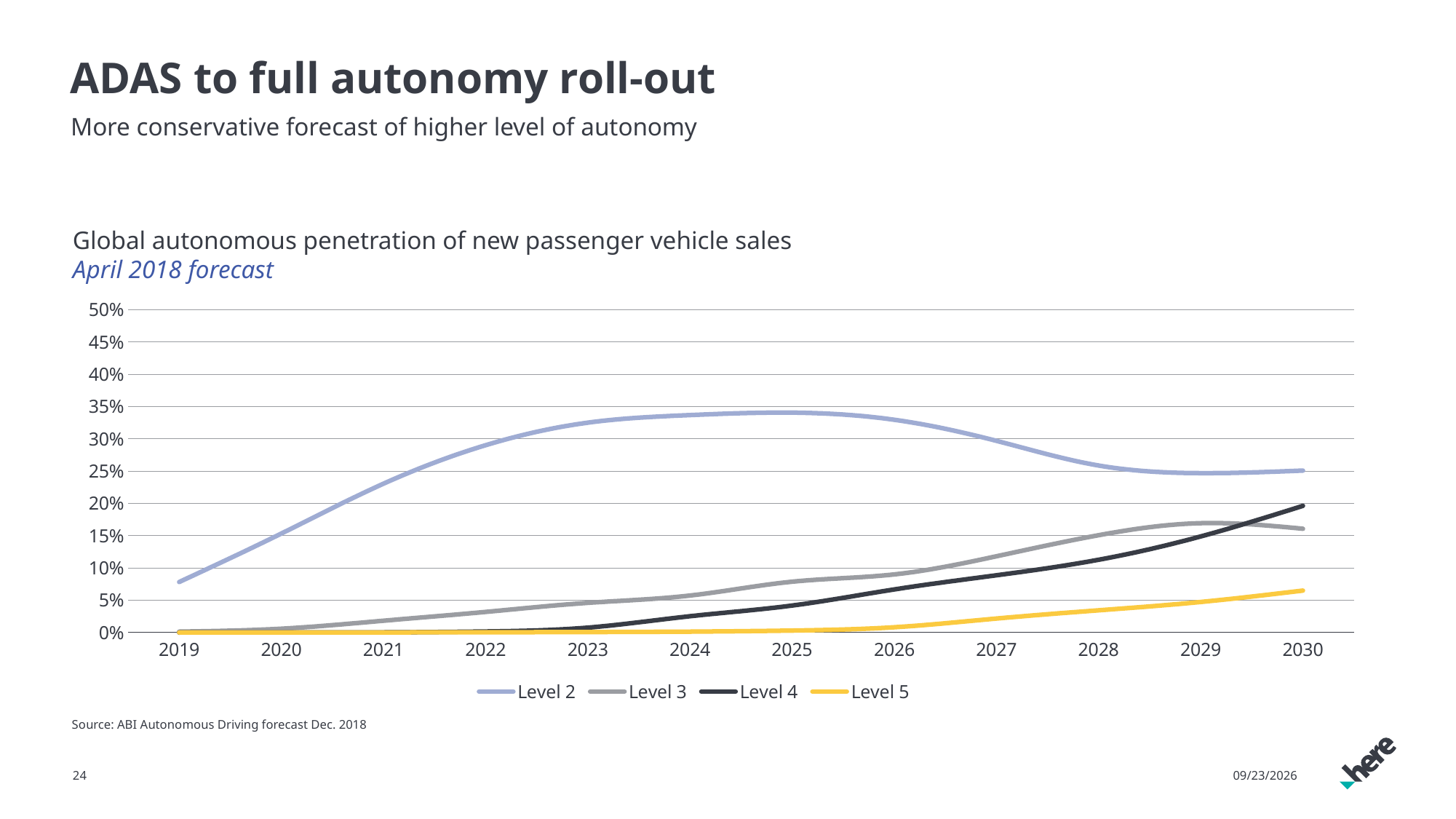
What kind of chart is shown on the slide? line chart How many years are shown along the x axis? 12 Which series has the lowest value in 2030? Level 5 Is the value for Level 5 in 2030 greater or less than 5%? greater Does the Level 4 line rise or fall from 2019 to 2030? rise In 2030, which is larger: Level 3 or Level 4? Level 4 Which series has the highest value in 2025? Level 2 Is the value for Level 2 in 2025 greater or less than 30%? greater Is the value for Level 4 in 2030 greater or less than 15%? greater How many series does the legend list? 4 What is the title of the chart? Global autonomous penetration of new passenger vehicle sales